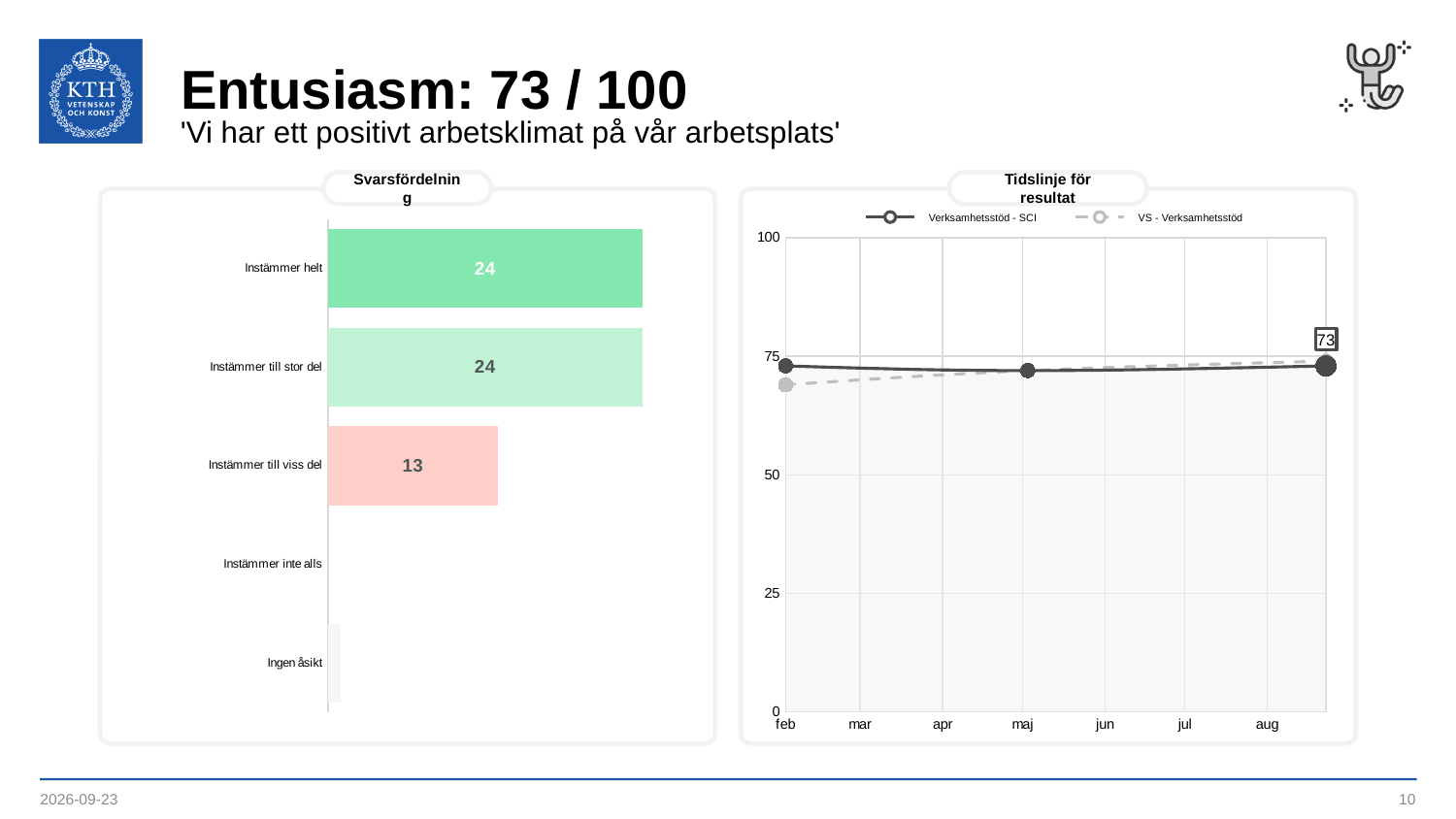
In the Svarsfördelning chart, which is larger: Instämmer till stor del or Instämmer till viss del? Instämmer till stor del In the Svarsfördelning chart, which of Instämmer helt, Instämmer till stor del and Instämmer till viss del has the lowest value? Instämmer till viss del In the Svarsfördelning chart, what is the value for Instämmer till viss del? 13 In the Svarsfördelning chart, what is the difference between the values for Instämmer helt and Instämmer till viss del? 11 In the Tidslinje för resultat chart, what is the labelled value of the last point of the Verksamhetsstöd - SCI series? 73 In the Tidslinje för resultat chart, is the value for Verksamhetsstöd - SCI in maj greater or less than 50? greater In the Tidslinje för resultat chart, how many series does the legend list? 2 In the Tidslinje för resultat chart, which two series are listed in the legend? Verksamhetsstöd - SCI and VS - Verksamhetsstöd In the Svarsfördelning chart, what is the value for Instämmer helt? 24 What kind of chart is the Svarsfördelning chart? bar chart In the Svarsfördelning chart, how many categories are shown on the axis? 5 What kind of chart is the Tidslinje för resultat chart? line chart